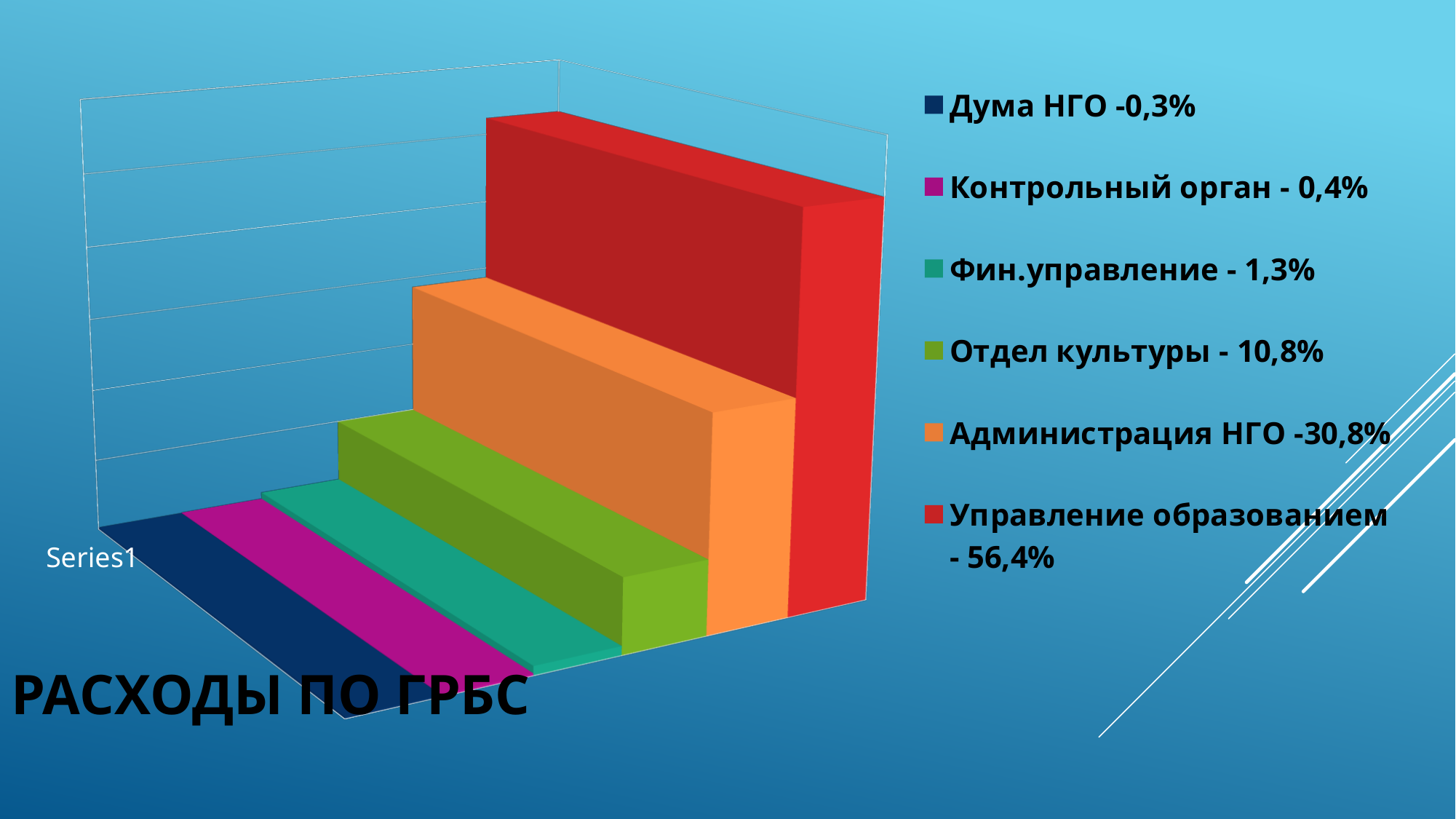
What is the value for Управление образованием? 56,4% Which is larger, the value for Контрольный орган or the value for Фин.управление? Фин.управление What is the value for Фин.управление? 1,3% What is the value for Отдел культуры? 10,8% What is the difference between the values for Администрация НГО and Отдел культуры? 20,0% What is the value for Администрация НГО? 30,8% What is the title of the chart? РАСХОДЫ ПО ГРБС How many categories are shown in the chart? 6 Which category has the highest value? Управление образованием What kind of chart is shown on the slide? 3D area chart Which category has the lowest value? Дума НГО What is the difference between the values for Управление образованием and Администрация НГО? 25,6%